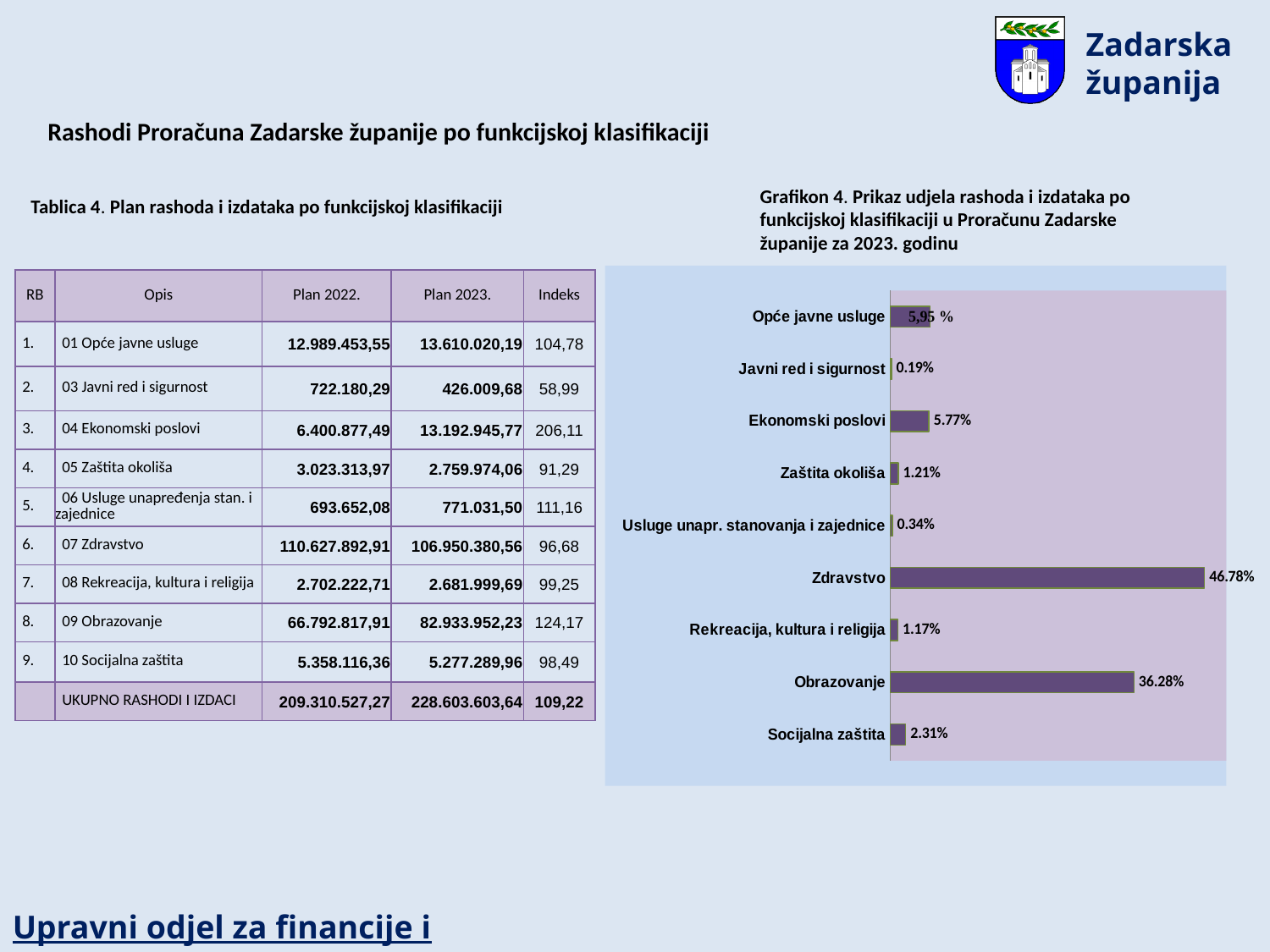
Which is larger, the value for Zaštita okoliša or the value for Rekreacija, kultura i religija? Zaštita okoliša Which category has the largest share in the chart? Zdravstvo What is the title of the chart on the slide? Grafikon 4. Prikaz udjela rashoda i izdataka po funkcijskoj klasifikaciji u Proračunu Zadarske županije za 2023. godinu What is the value shown for Ekonomski poslovi? 5.77% What is the difference between the values for Zdravstvo and Obrazovanje? 10.50% Which category has the smallest share in the chart? Javni red i sigurnost What type of chart is shown on the slide? Bar chart What share does Zdravstvo have in the chart? 46.78% What is the value shown for Javni red i sigurnost? 0.19% What is the value shown for Socijalna zaštita? 2.31% How many categories are shown in the chart? 9 What is the value shown for Obrazovanje? 36.28%